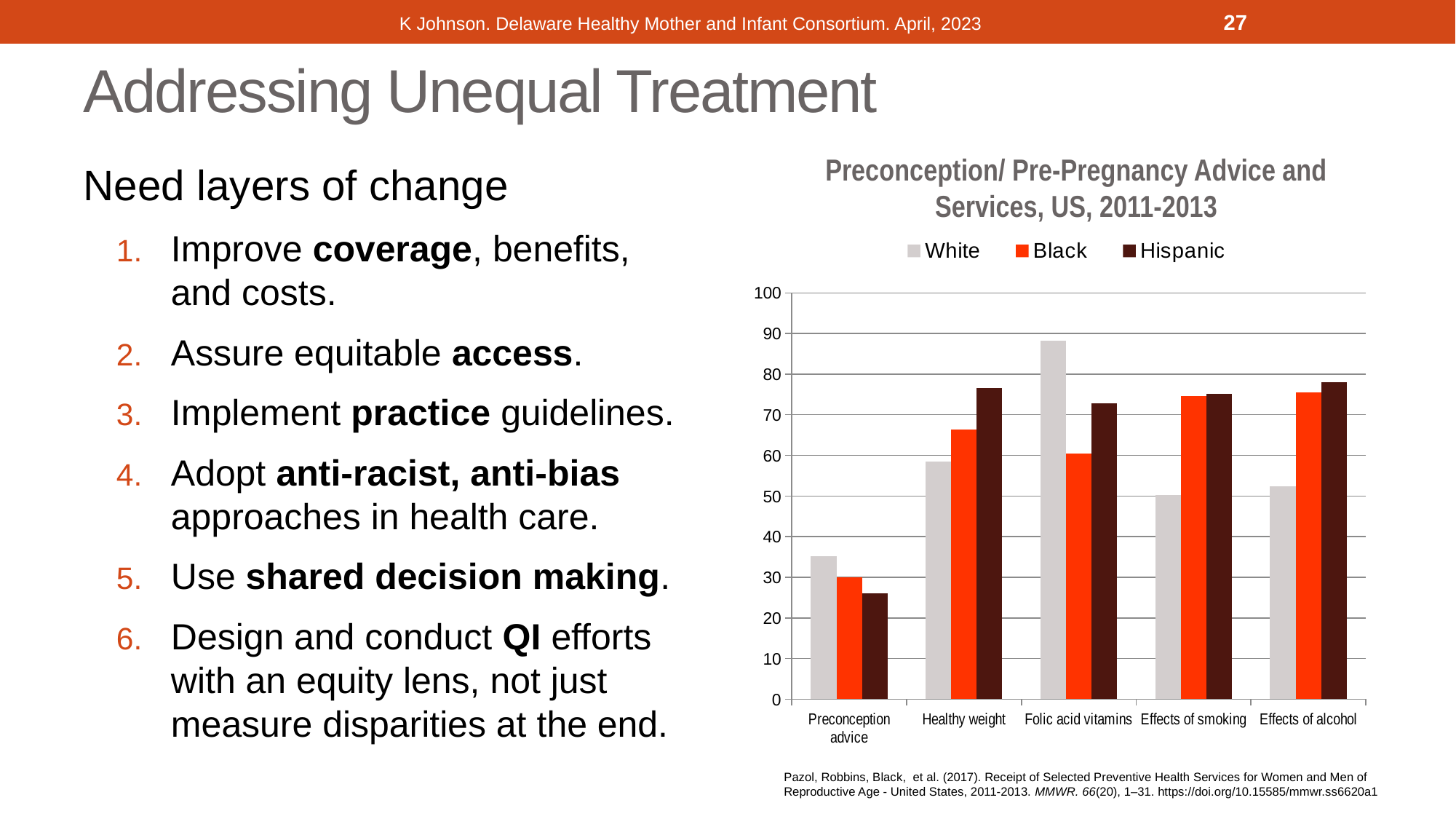
Which series is shown in light gray in the chart? White For the Hispanic series, which category has the lowest value? Preconception advice What kind of chart is shown on the slide? Bar chart How many categories are shown along the x axis of the chart? 5 Is the White value for Folic acid vitamins greater or less than 80? greater How many series does the chart legend list? 3 Is the Black value for Effects of smoking greater or less than 70? greater Is the Hispanic value for Preconception advice greater or less than 30? less For the White series, which category has the highest value? Folic acid vitamins In the Healthy weight category, which is larger: the Black value or the Hispanic value? Hispanic In the Folic acid vitamins category, which is larger: the White value or the Black value? White What is the title of the chart? Preconception/ Pre-Pregnancy Advice and Services, US, 2011-2013